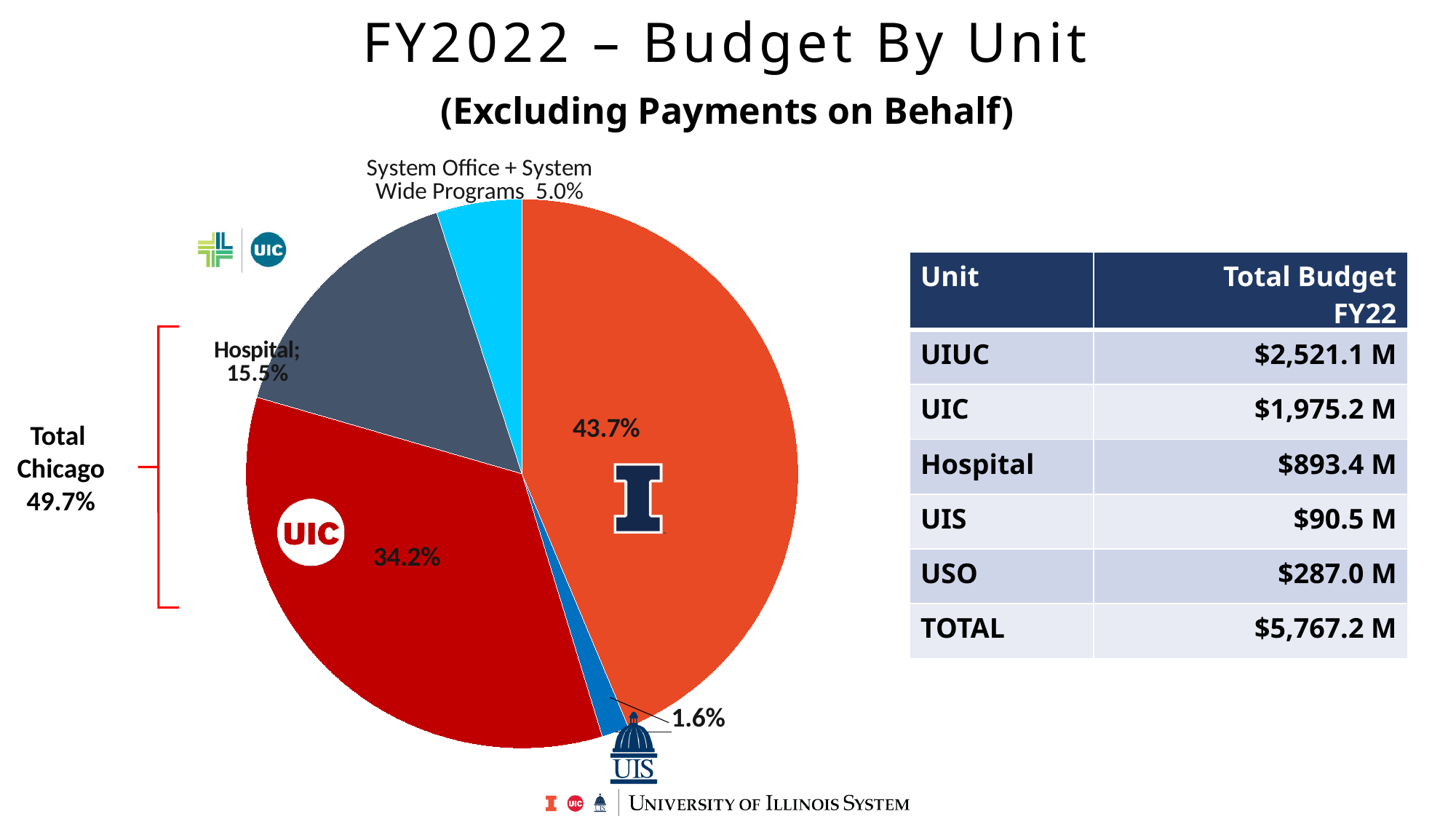
What share of the pie does the slice marked with the UIS logo represent? 1.6% What share of the pie does the Hospital slice represent? 15.5% Which is larger, the Hospital slice or the System Office + System Wide Programs slice? Hospital What is the difference in percentage points between the UIC slice (34.2%) and the Hospital slice (15.5%)? 18.7 Which slice of the pie is the largest? UIUC What combined share is labeled as 'Total Chicago' on the slide? 49.7% Which slice of the pie is the smallest? UIS What kind of chart is shown on the slide? pie chart What share of the pie does the System Office + System Wide Programs slice represent? 5.0% How many slices does the pie chart have? 5